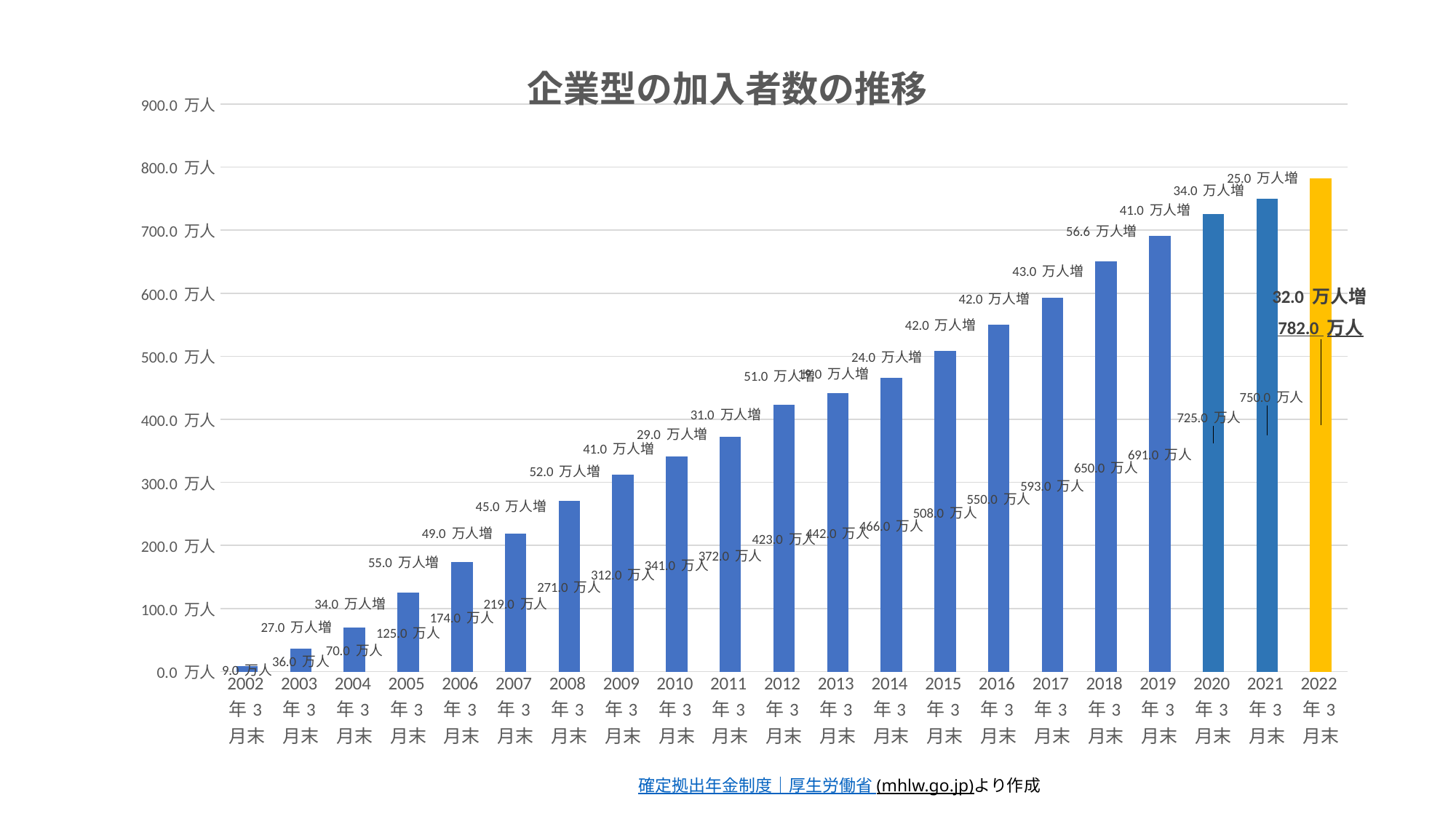
How many bars (years) are plotted in the chart? 21 What is the difference between the values for 2021年3月末 and 2020年3月末? 25.0 万人 What is the value for 2022年3月末? 782.0 万人 Which year has the lowest value? 2002年3月末 What type of chart is shown on the slide? bar chart What colour is the bar for 2022年3月末? yellow/orange What is the title of the chart? 企業型の加入者数の推移 What is the value for 2012年3月末? 423.0 万人 Do the values rise or fall from 2002 to 2022 along the x axis? rise What is the value for 2002年3月末? 9.0 万人 Which is larger, the value for 2015年3月末 or 2016年3月末? 2016年3月末 Which year has the highest value? 2022年3月末